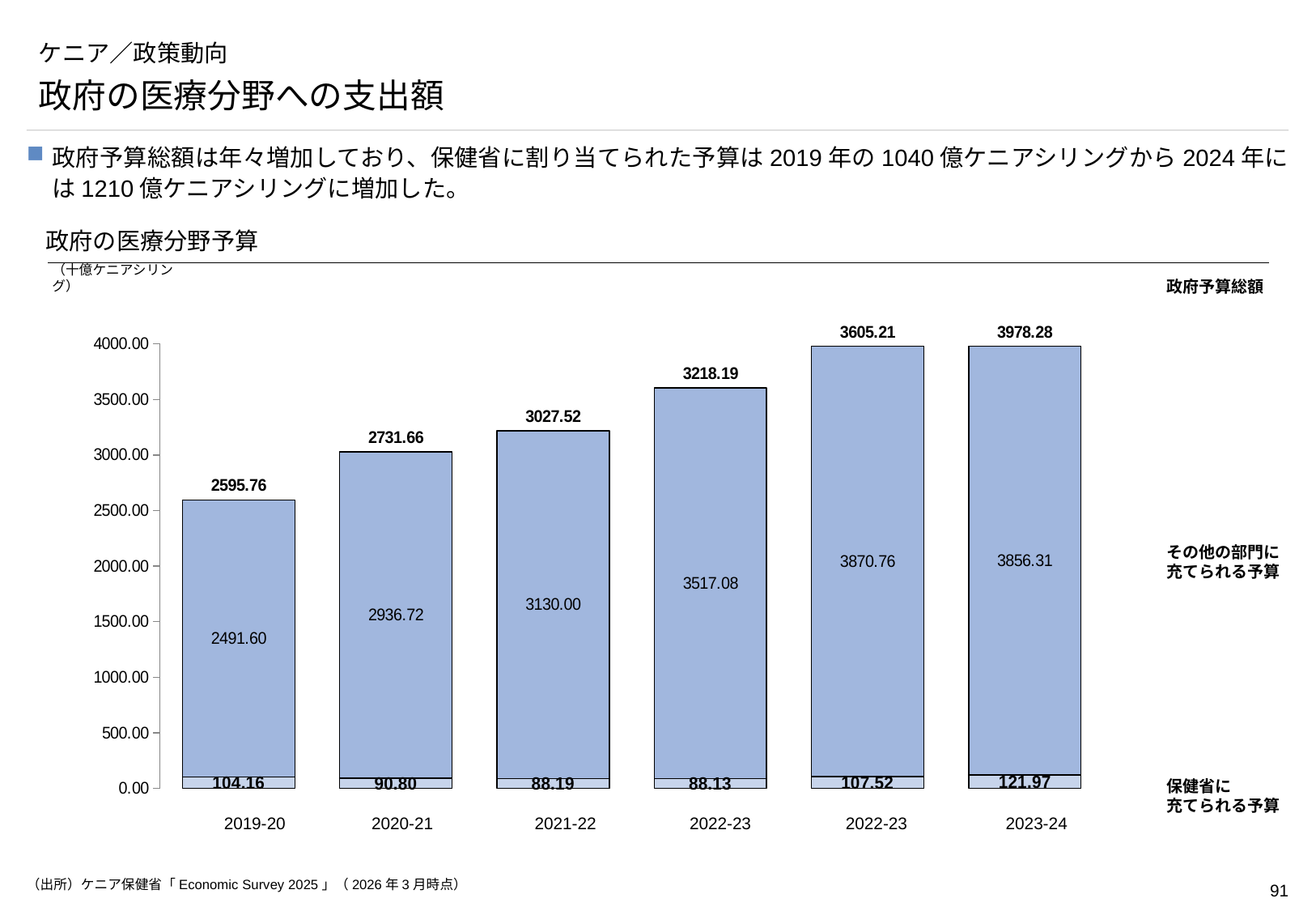
What is the title of the chart? 政府の医療分野予算 What is the value of その他の部門に充てられる予算 for 2020-21? 2936.72 What is the difference between the 保健省に充てられる予算 for 2023-24 and for 2019-20? 17.81 What is the 政府予算総額 label shown above the 2019-20 bar? 2595.76 What is the value of 保健省に充てられる予算 for 2023-24? 121.97 Is the 政府予算総額 for 2021-22 greater or less than 3000.00? greater Which fiscal year has the highest 保健省に充てられる予算? 2023-24 What kind of chart is used on this slide? Stacked bar chart Which fiscal year has the lowest 政府予算総額? 2019-20 How many bars are shown in the chart? 6 Does the 政府予算総額 rise or fall from 2019-20 to 2023-24? Rise Which is larger, the 保健省に充てられる予算 for 2020-21 or for 2021-22? 2020-21